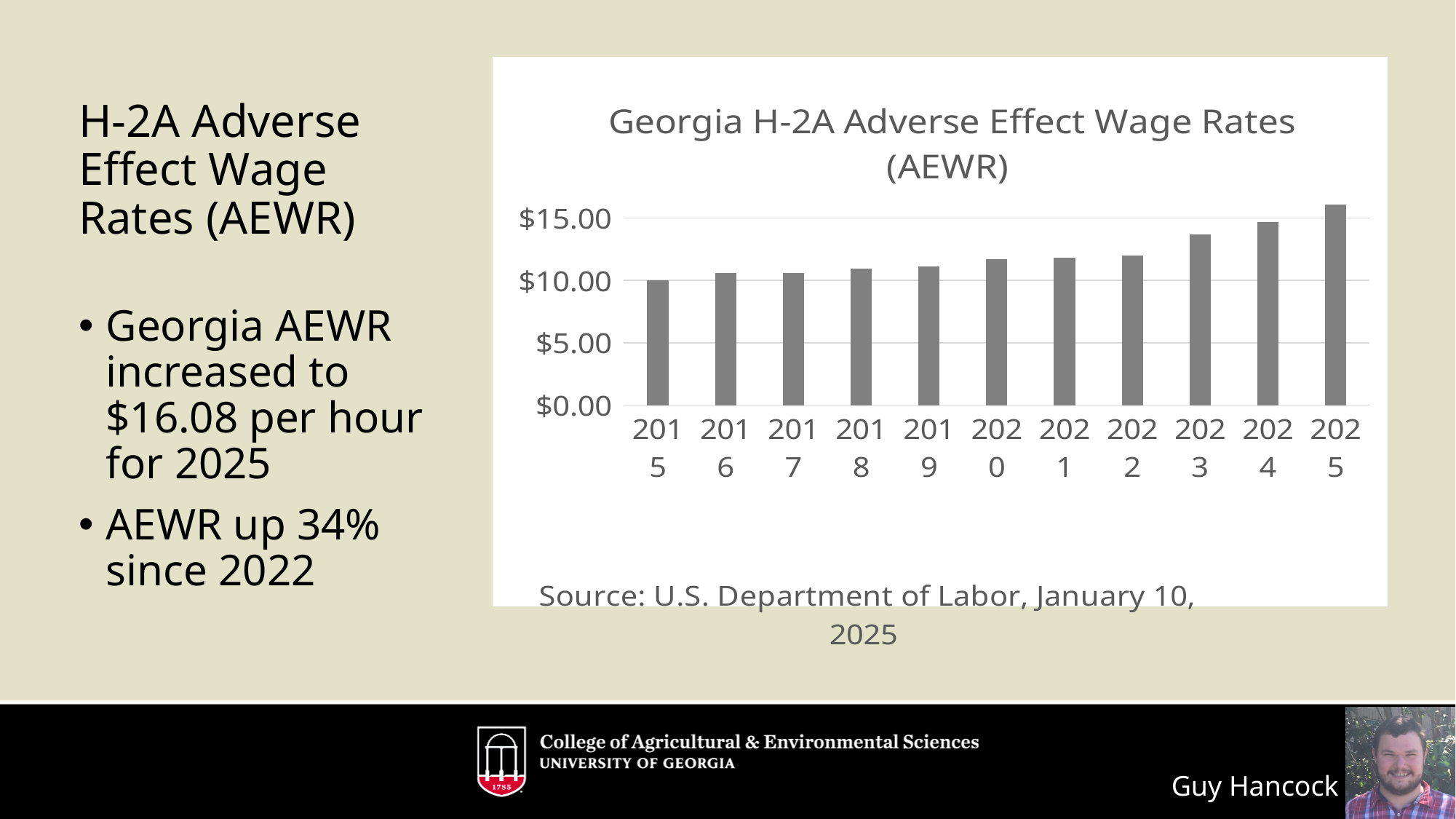
Do the AEWR values rise or fall from 2015 to 2025? rise What type of chart is shown on the slide? bar chart According to the slide, what is the Georgia AEWR per hour for 2025? $16.08 Which year has the lowest AEWR in the chart? 2015 Is the AEWR value for 2020 greater or less than $10.00? greater Which year has a higher AEWR, 2023 or 2020? 2023 Which year has the highest AEWR in the chart? 2025 Which year has a higher AEWR, 2015 or 2025? 2025 Is the AEWR value for 2025 greater or less than $15.00? greater What is the title of the chart? Georgia H-2A Adverse Effect Wage Rates (AEWR) How many years are plotted in the chart? 11 Is the AEWR value for 2023 greater or less than $15.00? less